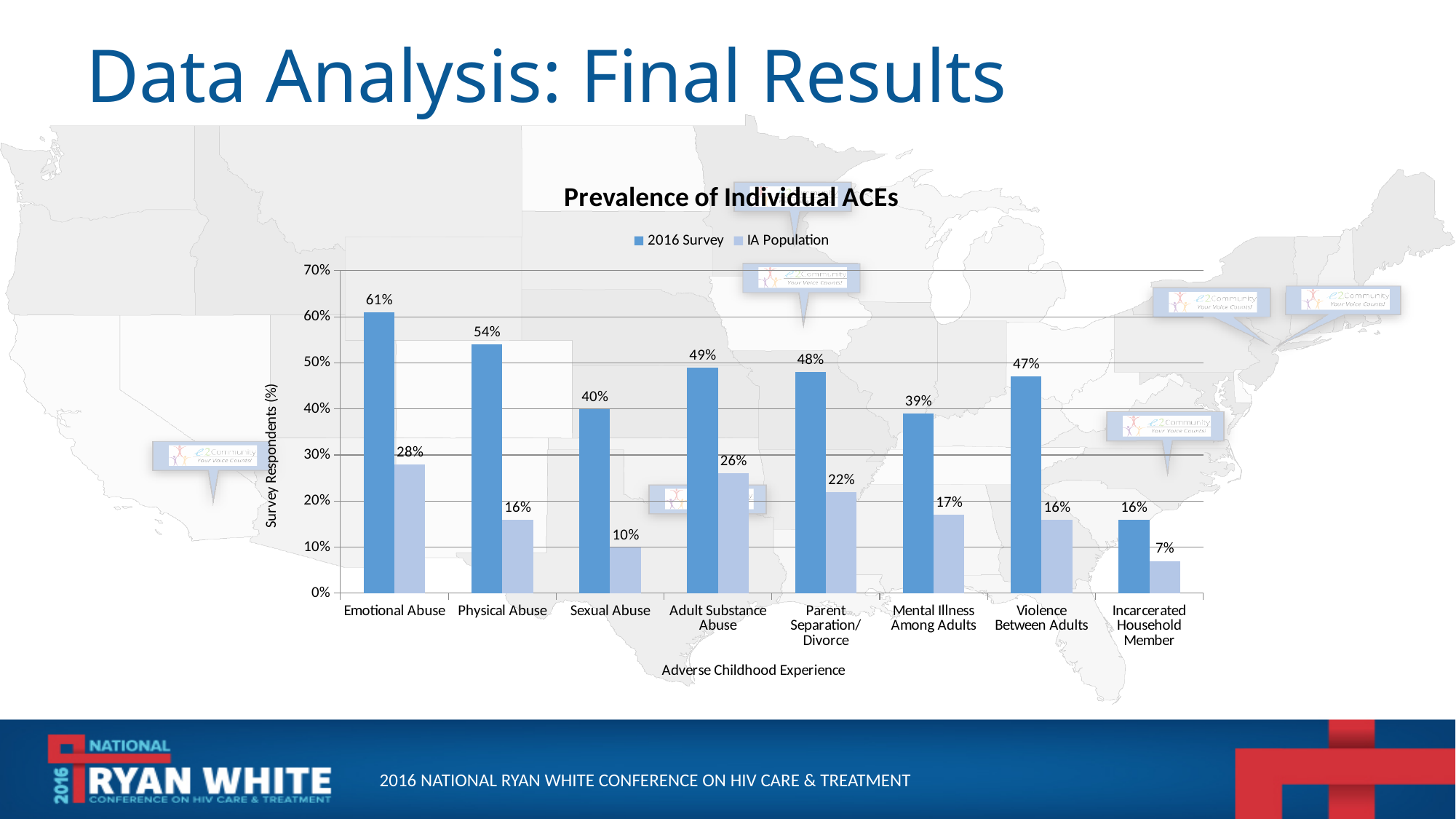
How many categories are shown on the x axis? 8 What is the IA Population value for Sexual Abuse? 10% What is the 2016 Survey value for Emotional Abuse? 61% What is the IA Population value for Parent Separation/Divorce? 22% What is the difference between the 2016 Survey and IA Population values for Physical Abuse? 38% How many series does the legend list? 2 Which is larger for Mental Illness Among Adults: the 2016 Survey value or the IA Population value? 2016 Survey What is the title of the chart? Prevalence of Individual ACEs Which category has the lowest IA Population value? Incarcerated Household Member What is the label of the y axis? Survey Respondents (%) Which category has the highest 2016 Survey value? Emotional Abuse What kind of chart is shown? Bar chart